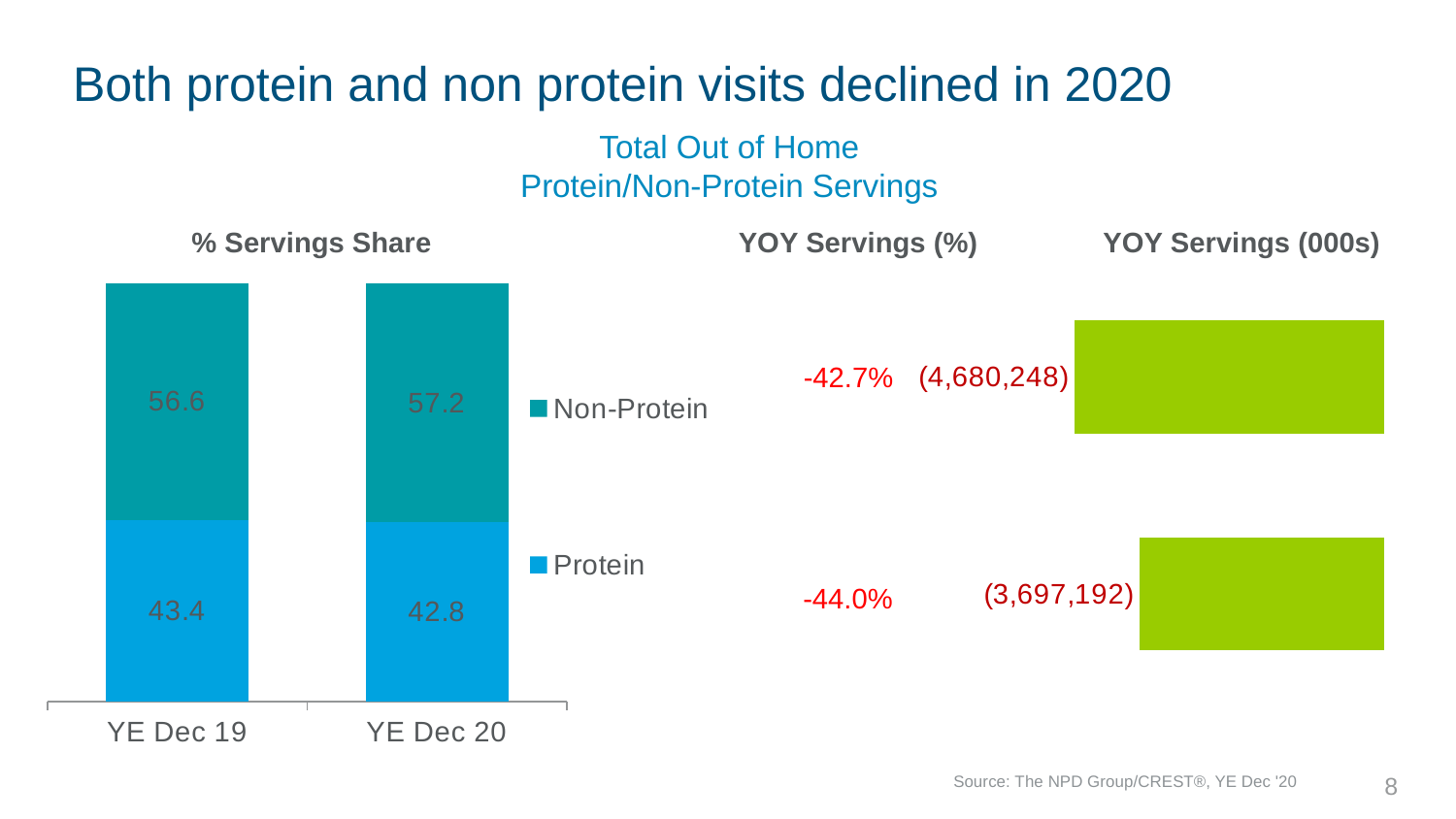
In the % Servings Share chart, how many series does the legend list? 2 In the % Servings Share chart, what is the Protein share for YE Dec 20? 42.8 In the YOY Servings (000s) column, what is the value shown for Protein? (3,697,192) In the YOY Servings (%) column, what is the year-over-year change for Non-Protein servings? -42.7% In the % Servings Share chart, what is the difference between the Non-Protein and Protein shares for YE Dec 20? 14.4 In the % Servings Share chart, what is the Non-Protein share for YE Dec 20? 57.2 What kind of chart is the % Servings Share chart? Stacked bar chart In the % Servings Share chart, which series has the larger share in YE Dec 19, Non-Protein or Protein? Non-Protein In the % Servings Share chart, what is the Non-Protein share for YE Dec 19? 56.6 In the % Servings Share chart, how many categories are shown on the x axis? 2 In the % Servings Share chart, what is the total of the stacked bar for YE Dec 19? 100 In the % Servings Share chart, what is the Protein share for YE Dec 19? 43.4